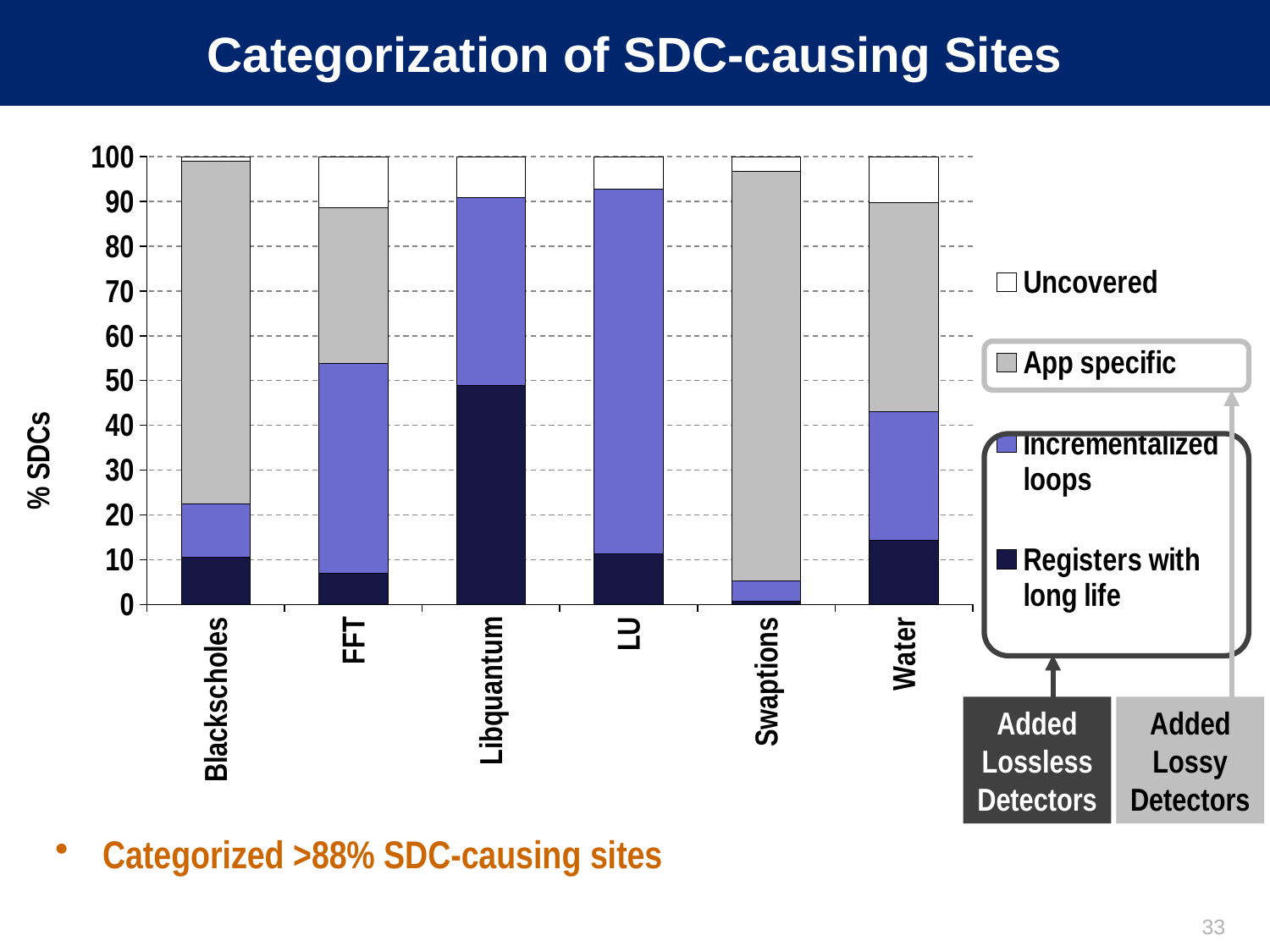
What is the title of the slide containing the chart? Categorization of SDC-causing Sites Which benchmark has the largest 'App specific' segment? Swaptions How many series does the chart's legend list? 4 Which benchmark has the largest 'Registers with long life' segment? Libquantum Which has the larger 'Uncovered' segment, FFT or Blackscholes? FFT Is the 'Registers with long life' value for Libquantum greater or less than 40? greater What type of chart is shown on the slide? Stacked bar chart Which benchmark has the smallest 'Registers with long life' segment? Swaptions Is the 'Registers with long life' value for Water greater or less than 10? greater How many benchmark categories are shown on the x axis of the chart? 6 Is the 'Registers with long life' value for FFT greater or less than 10? less Which has the larger 'Incrementalized loops' segment, LU or Blackscholes? LU